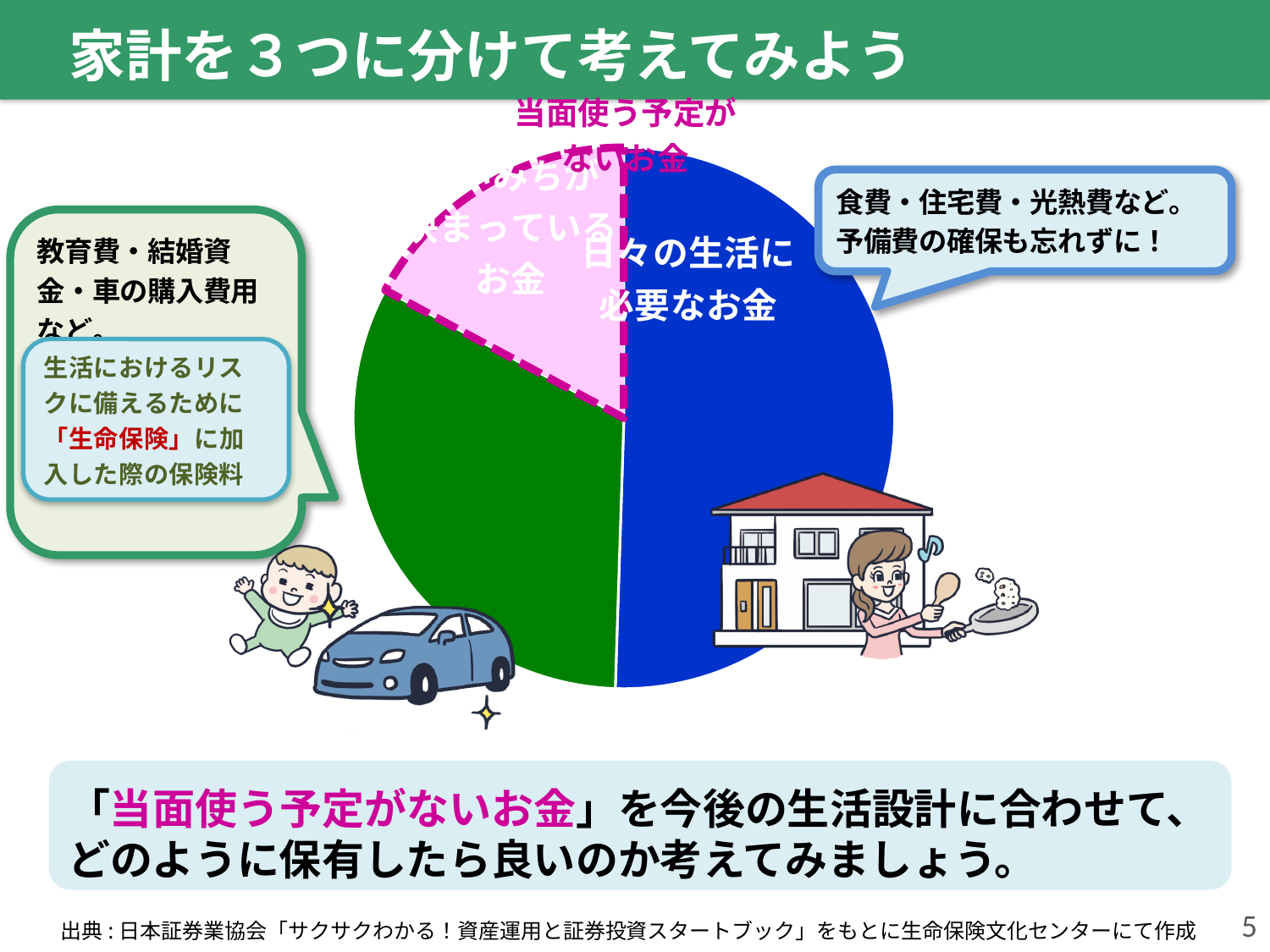
Which slice of the pie chart is the largest? 日々の生活に必要なお金 What kind of chart is shown on the slide? pie chart Which slice of the pie chart is the smallest? 当面使う予定がないお金 What colour is the slice for 当面使う予定がないお金? pink Which slice is larger: 日々の生活に必要なお金 or 当面使う予定がないお金? 日々の生活に必要なお金 How many slices does the pie chart have? 3 What colour is the slice for 日々の生活に必要なお金? blue Is the slice for 当面使う予定がないお金 larger or smaller than the green slice? smaller